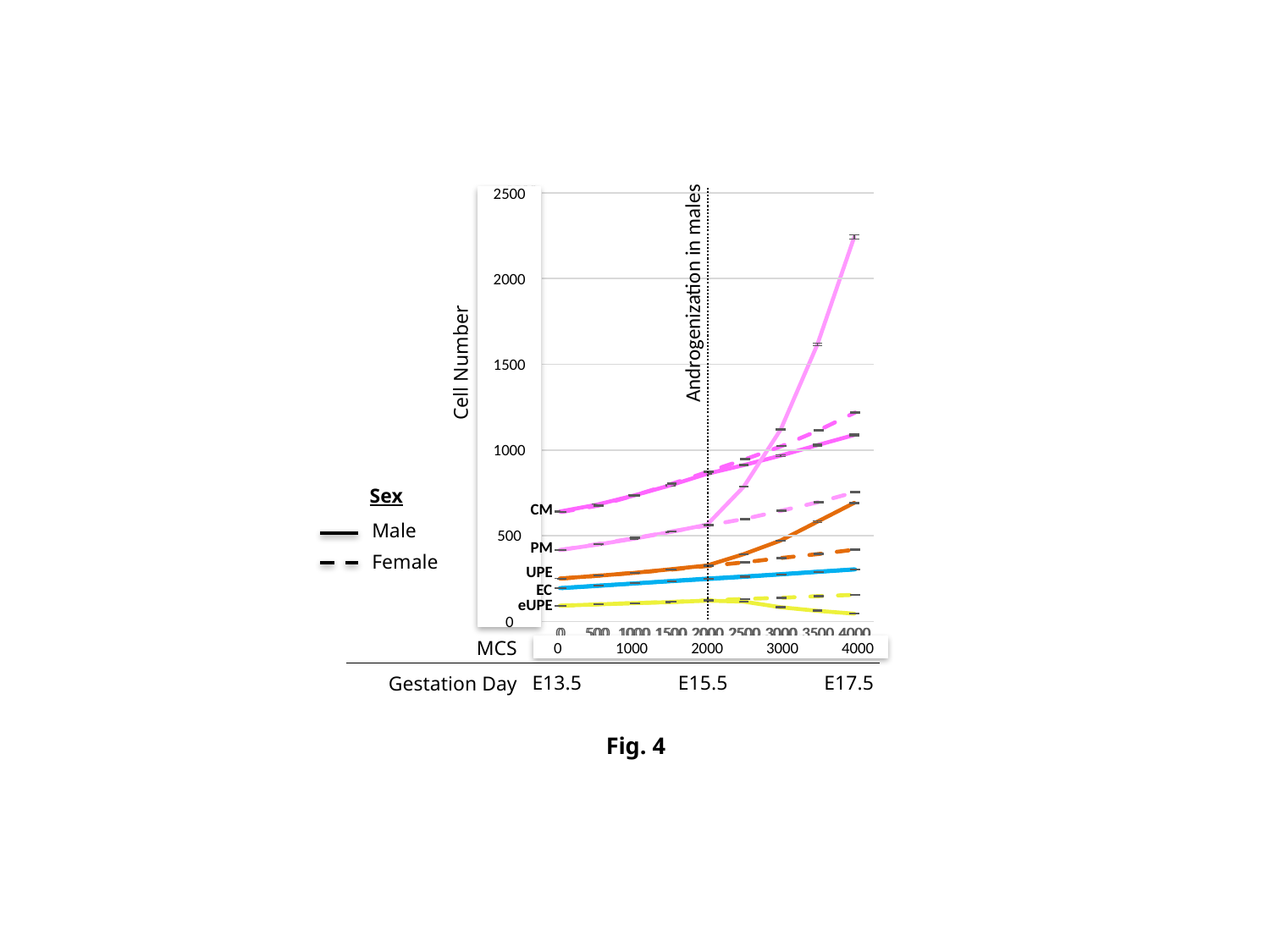
What is the label of the y axis? Cell Number How many cell types are labelled on the chart (CM, PM, UPE, EC, eUPE)? 5 Is the male PM cell number at MCS 4000 greater or less than 2000? greater Is the EC cell number at MCS 4000 greater or less than 500? less What event does the vertical dotted line at MCS 2000 mark? Androgenization in males Which cell type has the highest male cell number at MCS 4000? PM Is the female CM cell number at MCS 4000 greater or less than 1000? greater What kind of chart is shown on the slide? line chart Does the male PM cell number rise or fall as MCS increases from 2000 to 4000? rise Which cell type has the lowest male cell number at MCS 4000? eUPE At MCS 4000, which is larger: the male UPE cell number or the female UPE cell number? male UPE